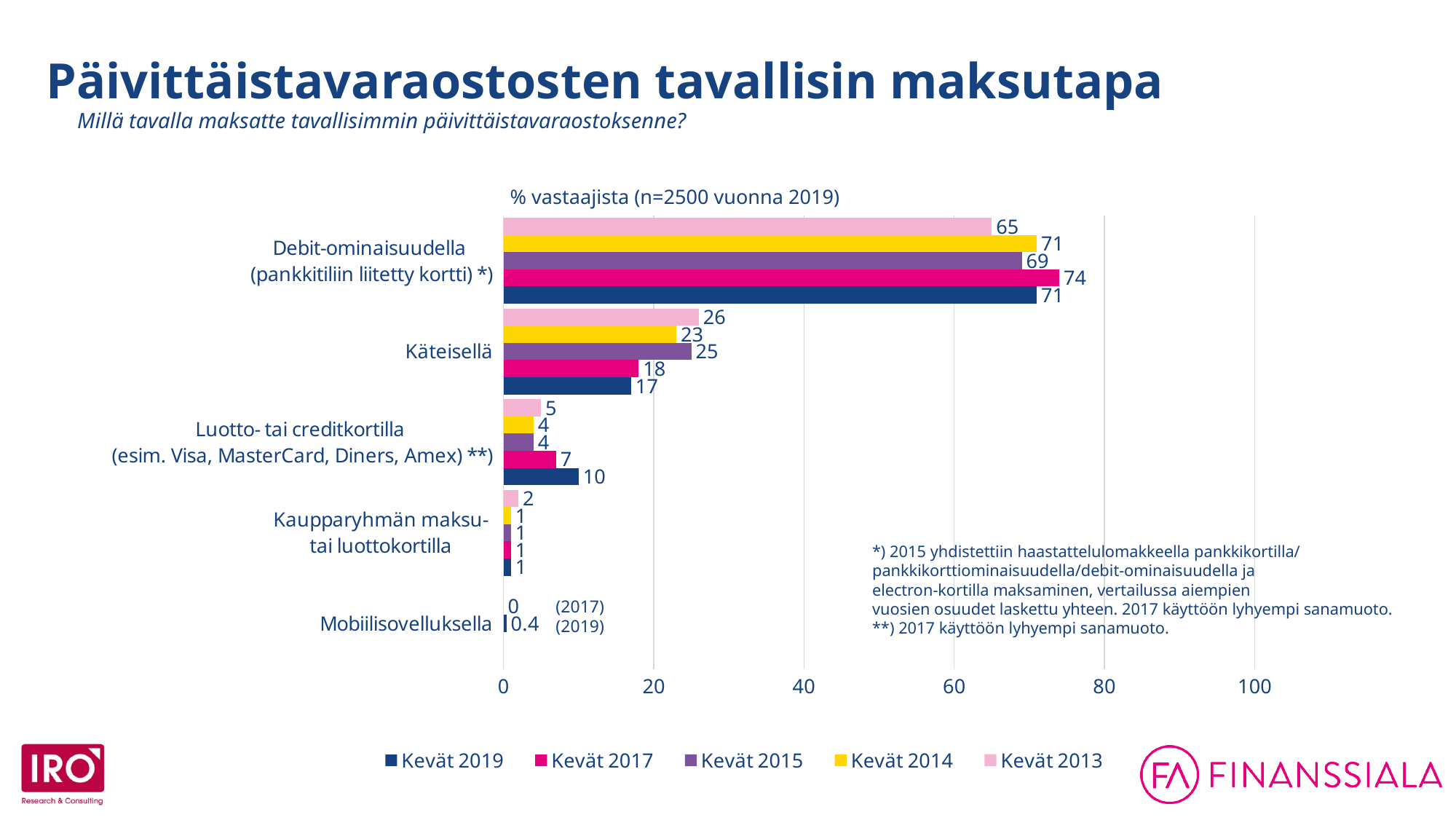
How many payment method categories are shown on the chart? 5 What is the Kevät 2013 value for Luotto- tai creditkortilla? 5 Which year has the highest value for Debit-ominaisuudella? Kevät 2017 What is the difference between the Kevät 2013 and Kevät 2019 values for Käteisellä? 9 What is the Kevät 2017 value for Käteisellä? 18 What is the Kevät 2019 value for Debit-ominaisuudella? 71 Which is larger for Luotto- tai creditkortilla: the Kevät 2019 value or the Kevät 2017 value? Kevät 2019 What is the axis title shown above the chart? % vastaajista (n=2500 vuonna 2019) What is the Kevät 2019 value for Mobiilisovelluksella? 0.4 How many series does the legend list? 5 What type of chart is shown on the slide? bar chart Which year has the lowest value for Käteisellä? Kevät 2019